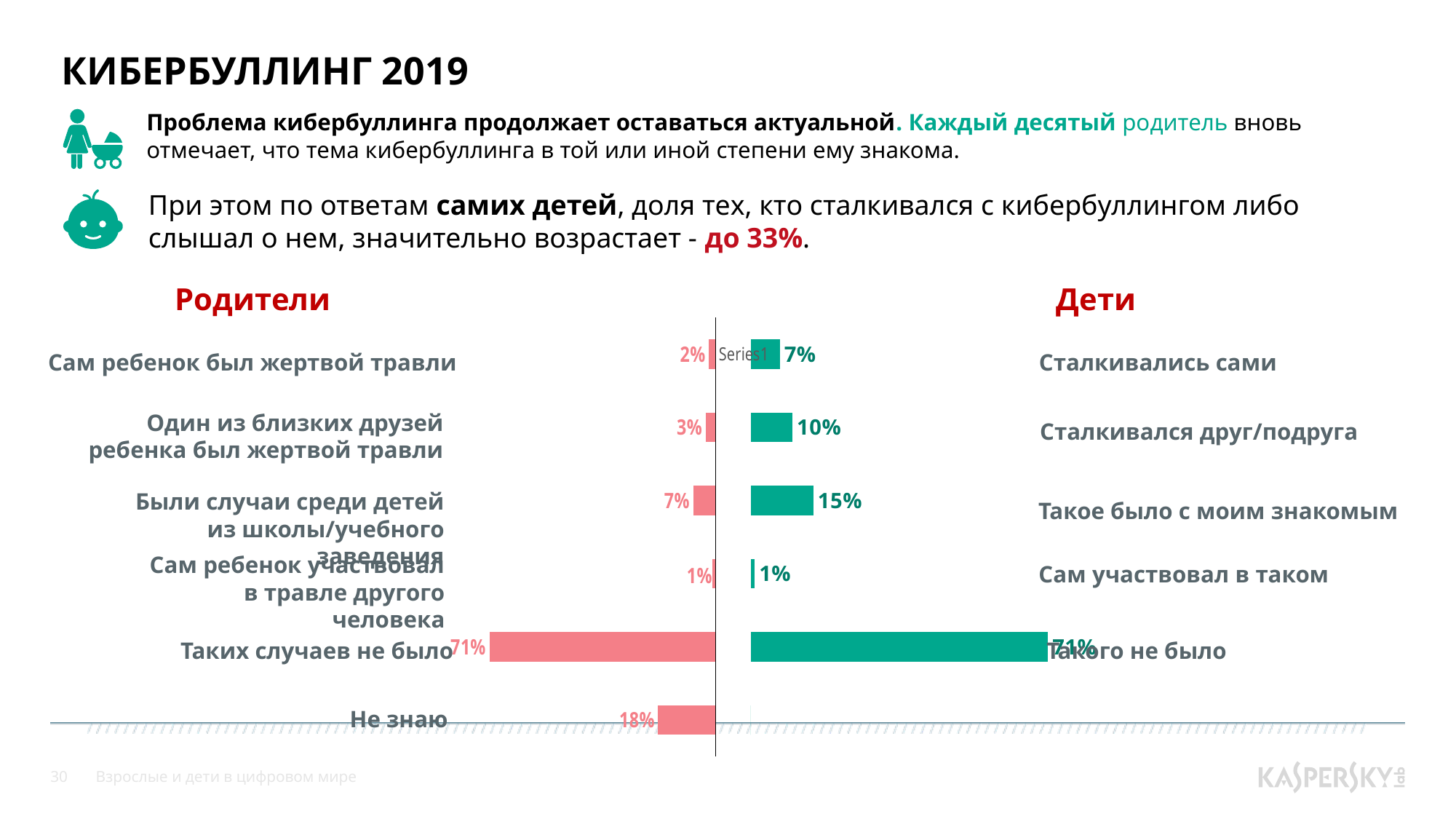
What percentage of children (Дети) answered "Сталкивался друг/подруга"? 10% What colour are the bars for children (Дети)? Green Which answer has the lowest value among children (Дети)? Сам участвовал в таком What type of chart is shown on the slide? Bar chart Which answer has the highest value among parents (Родители)? Таких случаев не было What percentage of parents (Родители) answered "Не знаю"? 18% How many answer categories are shown for children (Дети)? 5 Which is larger: the children's value for "Такое было с моим знакомым" or the parents' value for "Были случаи среди детей из школы/учебного заведения"? Такое было с моим знакомым (children) What is the difference between the children's value for "Сталкивались сами" and the parents' value for "Сам ребенок был жертвой травли"? 5% What percentage of children (Дети) answered "Такое было с моим знакомым"? 15% What percentage of parents (Родители) answered "Сам ребенок был жертвой травли"? 2% How many answer categories are shown for parents (Родители)? 6